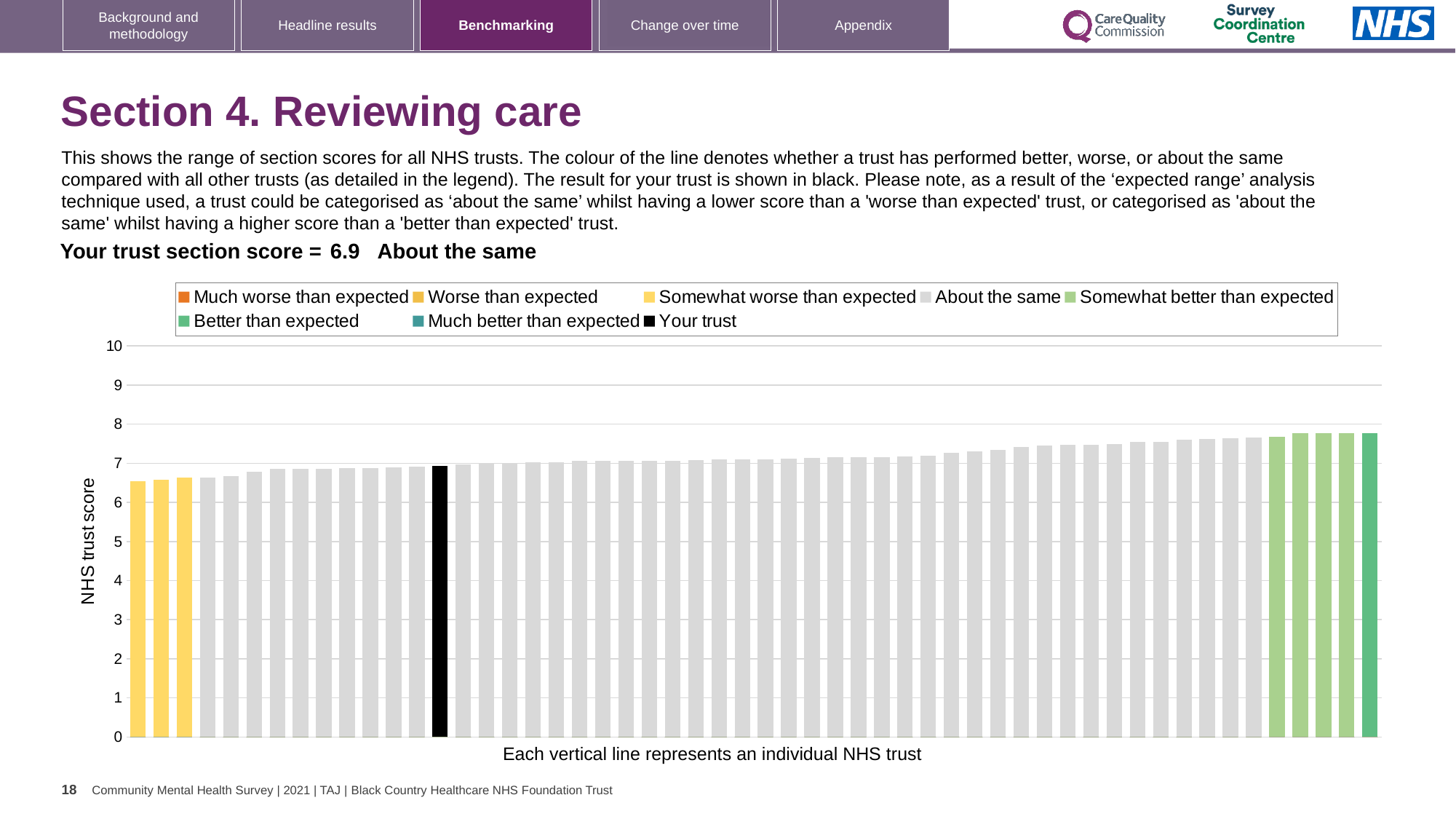
Which performance category is your trust placed in for this section? About the same How many entries does the chart legend list? 8 Do the bar values rise or fall from left to right along the x axis? rise Is the value of the tallest bar greater or less than 8? less What is the section score for your trust? 6.9 What kind of chart is shown on the slide? bar chart How many bars are coloured as 'Somewhat worse than expected' (yellow)? 3 Which is larger, the bar for your trust or the leftmost bar? your trust What is the label on the y axis? NHS trust score Is the value of the shortest bar greater or less than 6? greater What colour is the bar representing your trust? black Is the value for your trust greater or less than 5? greater